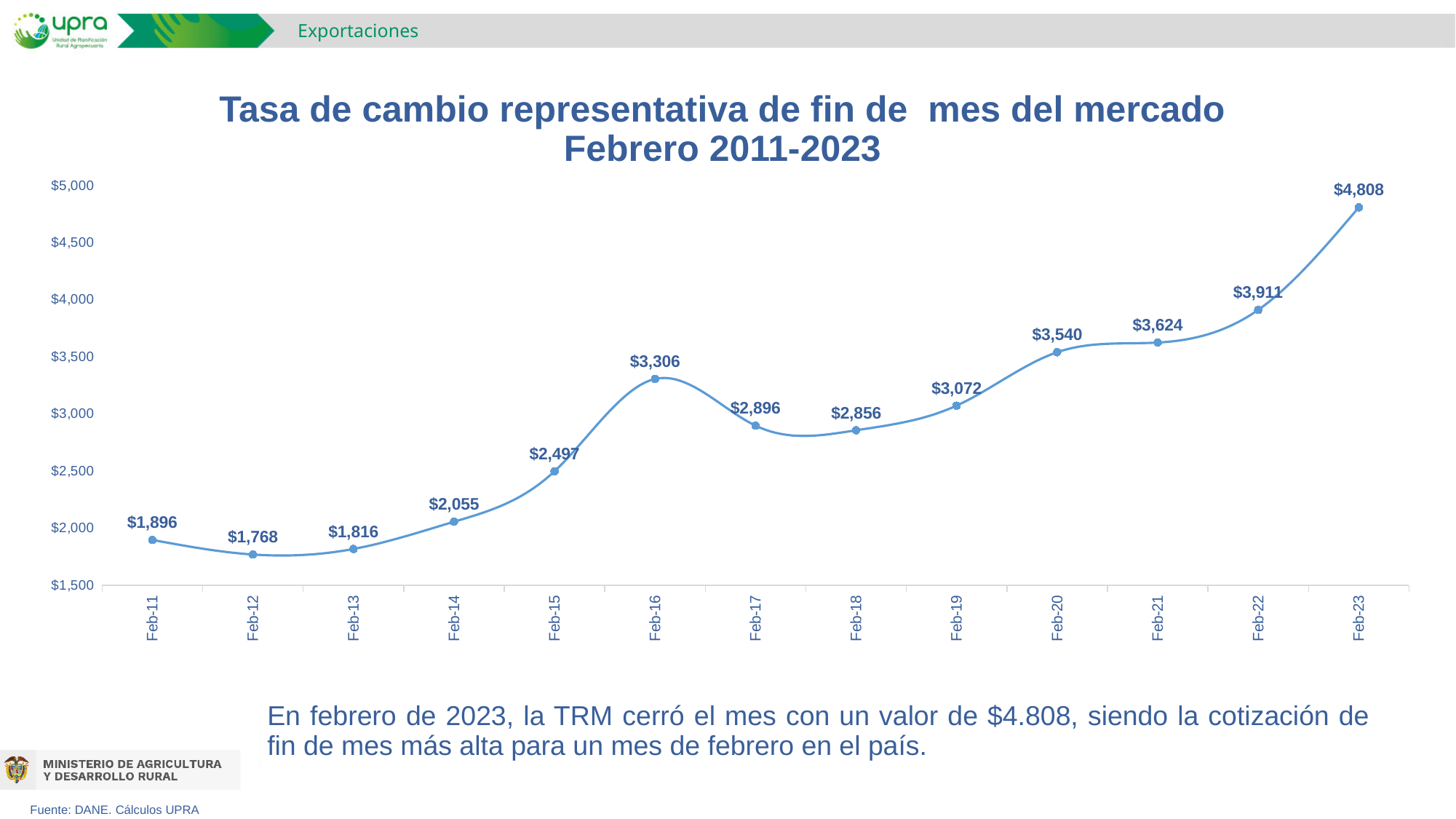
Do the values rise or fall from Feb-18 to Feb-23? rise What is the value for Feb-20? $3,540 Which is larger, the value for Feb-16 or the value for Feb-19? Feb-16 How many data points are plotted on the chart? 13 What kind of chart is shown on the slide? line chart What is the difference between the values for Feb-23 and Feb-22? $897 What is the value for Feb-11? $1,896 Which month has the lowest value? Feb-12 What is the value for Feb-16? $3,306 Which month has the highest value? Feb-23 Is the value for Feb-17 greater or less than $3,000? less What is the title of the chart? Tasa de cambio representativa de fin de mes del mercado Febrero 2011-2023